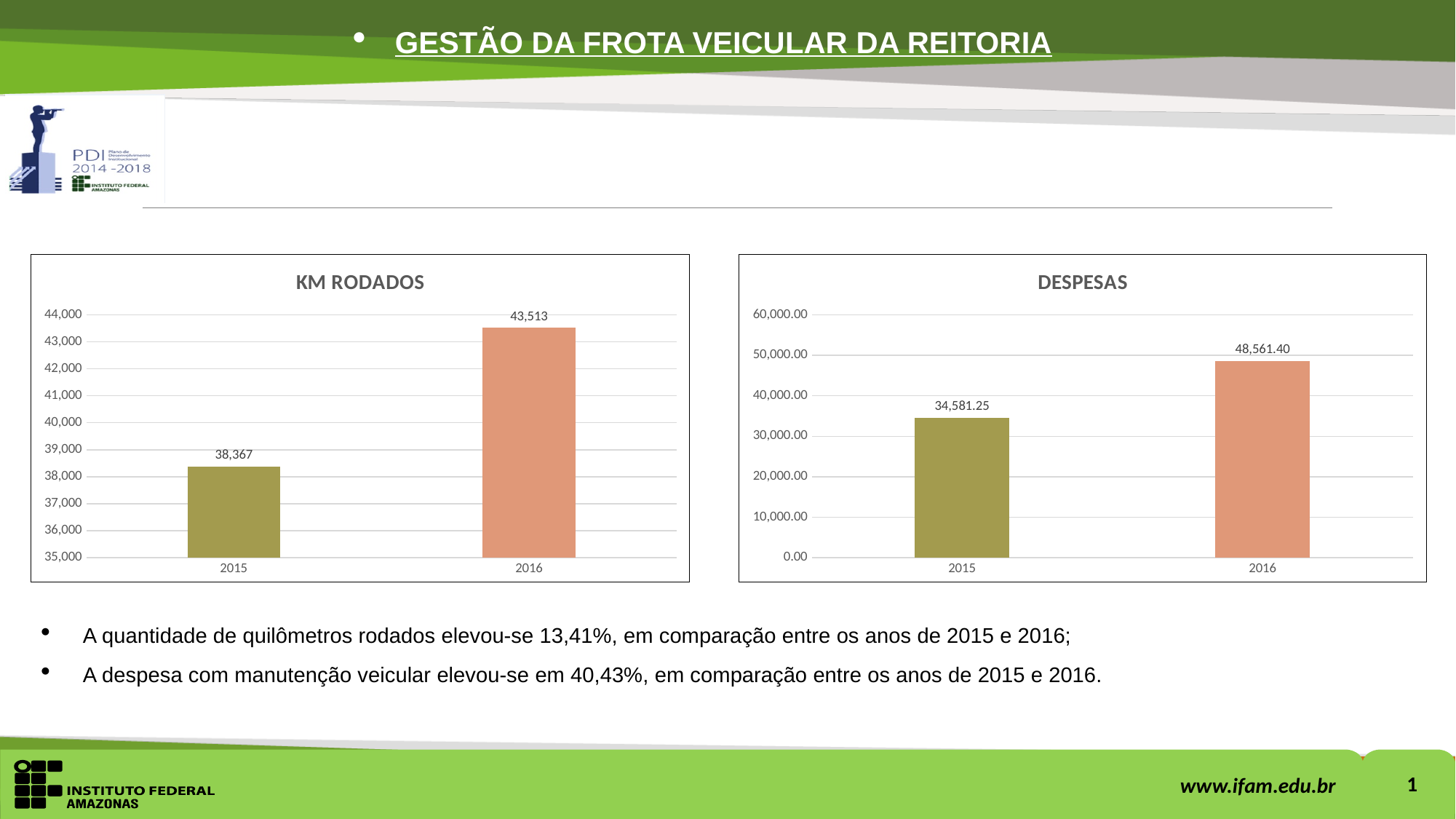
In the KM RODADOS chart, what is the value for 2016? 43,513 In the DESPESAS chart, what is the value for 2016? 48,561.40 In the DESPESAS chart, what is the value for 2015? 34,581.25 In the KM RODADOS chart, what is the difference between the 2016 and 2015 values? 5,146 In the DESPESAS chart, is the value for 2016 greater or less than 40,000.00? greater In the KM RODADOS chart, do the values rise or fall from 2015 to 2016? rise How many categories are shown on the x axis of the KM RODADOS chart? 2 In the KM RODADOS chart, which year has the highest value? 2016 In the DESPESAS chart, what is the difference between the 2016 and 2015 values? 13,980.15 In the DESPESAS chart, which year has the lowest value? 2015 What kind of chart is the DESPESAS chart? bar chart In the KM RODADOS chart, what is the value for 2015? 38,367